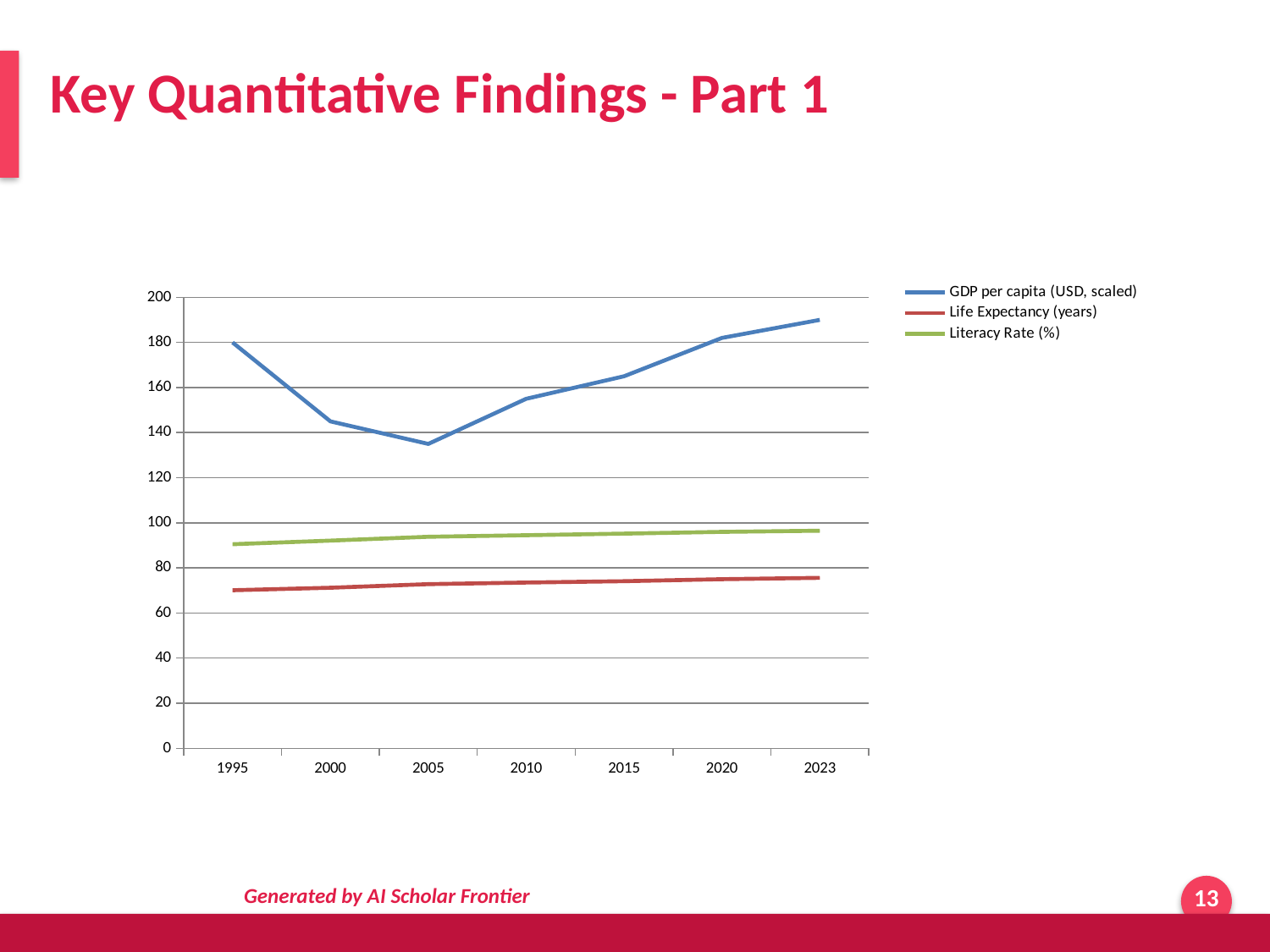
In which year is the GDP per capita (USD, scaled) line at its highest? 2023 In 2010, which series has the larger value: Literacy Rate (%) or Life Expectancy (years)? Literacy Rate (%) What kind of chart is shown on the slide? line chart Is the value for GDP per capita (USD, scaled) in 2005 greater or less than 140? less How many series does the legend list? 3 Is the value for Literacy Rate (%) in 1995 greater or less than 100? less In which year is the GDP per capita (USD, scaled) line at its lowest? 2005 Is the value for GDP per capita (USD, scaled) in 2023 greater or less than 180? greater How many years are plotted along the x axis? 7 Which series is drawn with the blue line? GDP per capita (USD, scaled) Does the Literacy Rate (%) line rise or fall from 1995 to 2023? rise